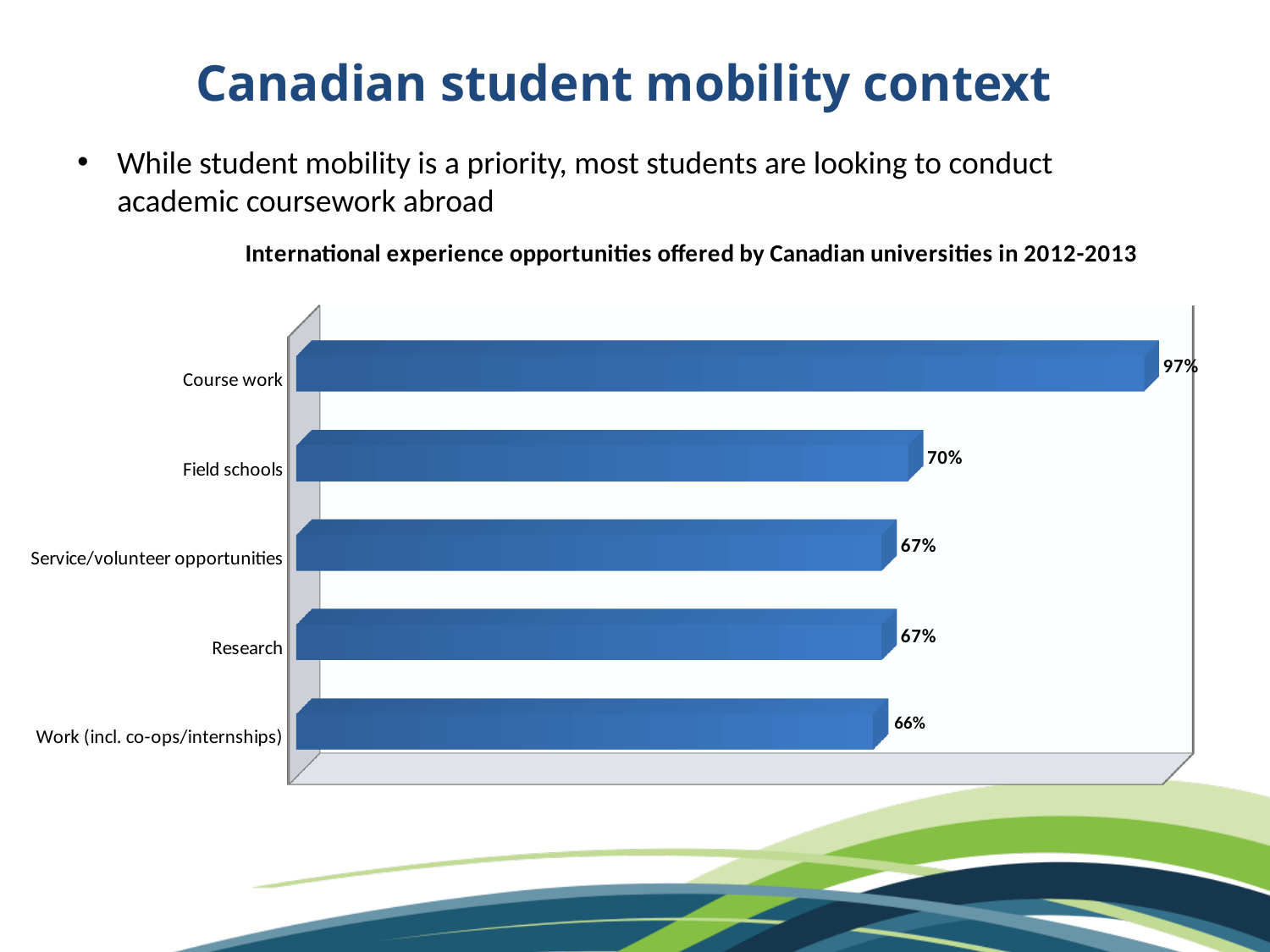
How many categories are shown in the chart? 5 Which category has the lowest value? Work (incl. co-ops/internships) Which category has the highest value? Course work What is the difference between the values for Field schools and Work (incl. co-ops/internships)? 4% What is the value for Research? 67% What is the difference between the values for Course work and Field schools? 27% Which is larger, the value for Field schools or the value for Service/volunteer opportunities? Field schools What is the title of the chart? International experience opportunities offered by Canadian universities in 2012-2013 What is the value for Field schools? 70% What kind of chart is shown on the slide? Bar chart What is the value for Work (incl. co-ops/internships)? 66% What is the value for Course work? 97%